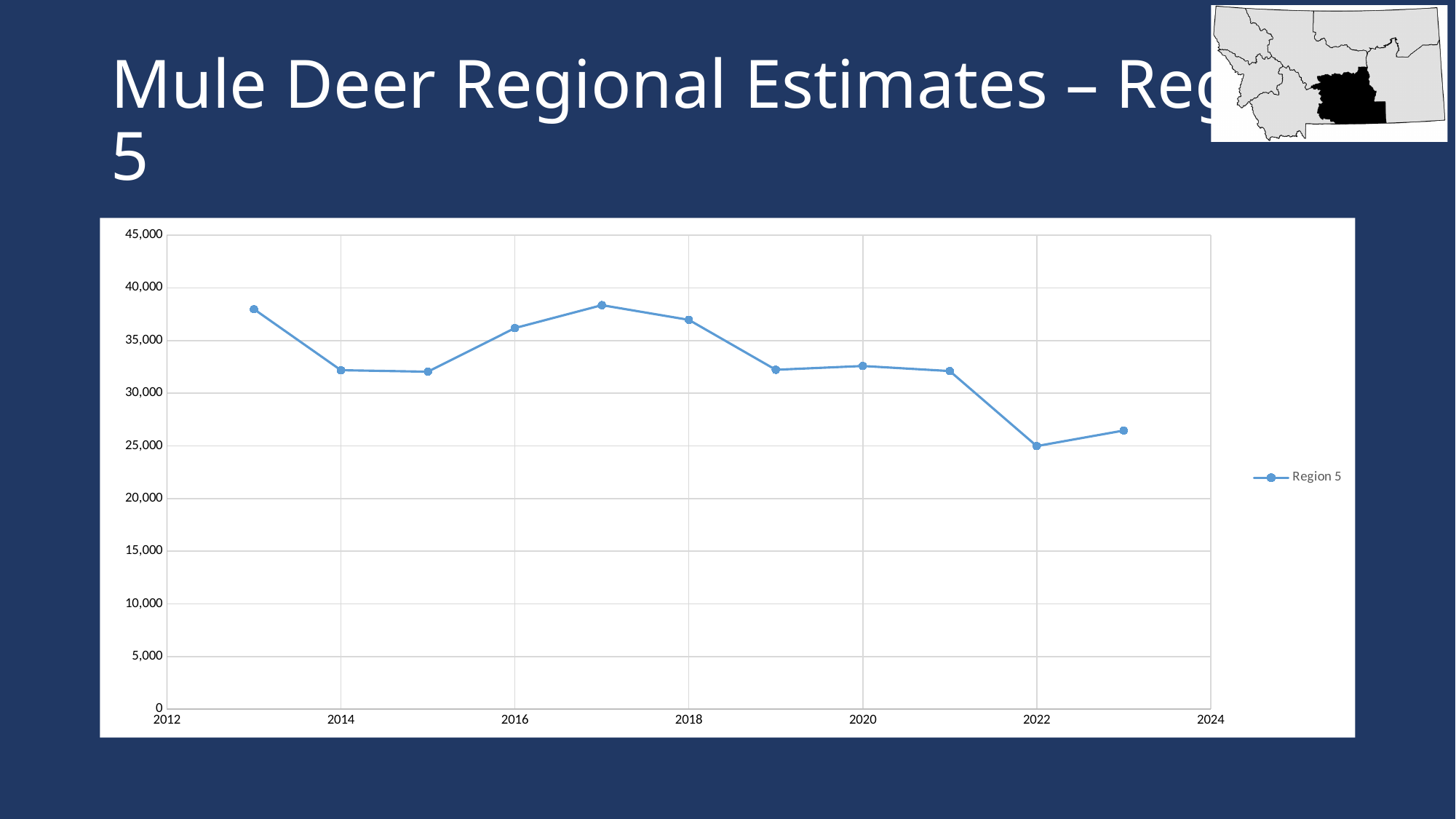
What kind of chart is shown on the slide? line chart Is the value for 2013 greater or less than 35,000? greater Do the values rise or fall from 2017 to 2022? fall Is the value for 2019 greater or less than 30,000? greater Is the value for 2014 greater or less than 35,000? less What is the name of the series shown in the legend? Region 5 Which is larger, the value for 2016 or the value for 2014? 2016 Which year has the lowest value? 2022 How many series does the legend list? 1 Which is larger, the value for 2018 or the value for 2021? 2018 How many data points are plotted on the line? 11